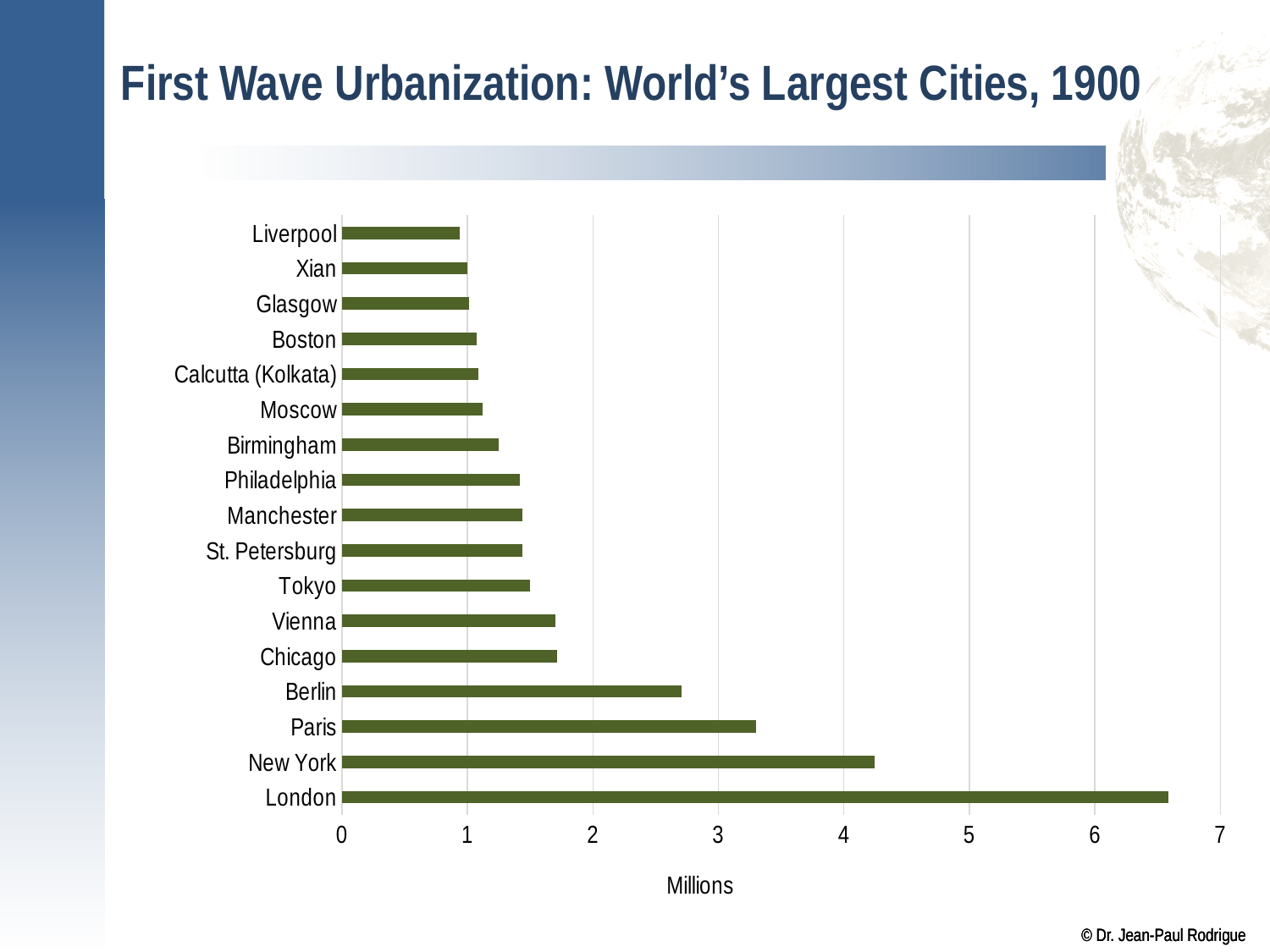
Is the value for Paris greater or less than 3? greater Is the value for Chicago greater or less than 2? less How many cities are plotted in the chart? 17 What is the label on the horizontal axis of the chart? Millions Is the value for London greater or less than 6? greater Which is larger, the value for New York or the value for London? London What is the title of the slide containing the chart? First Wave Urbanization: World's Largest Cities, 1900 Which is larger, the value for Paris or the value for Berlin? Paris Which city has the largest population in the chart? London What kind of chart is shown on the slide? Bar chart